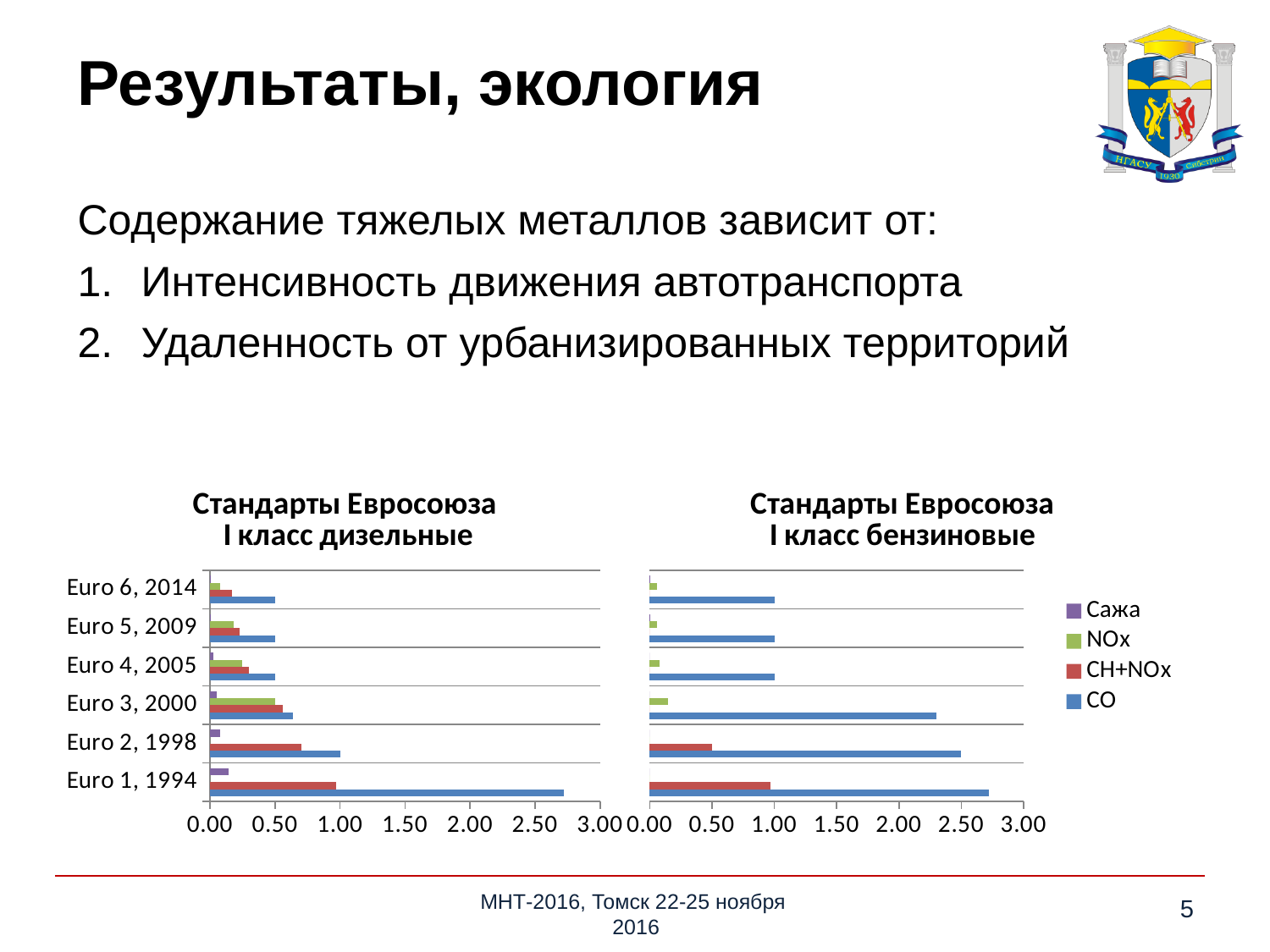
In the left chart 'Стандарты Евросоюза I класс дизельные', is the CO value for Euro 1, 1994 greater or less than 2.50? greater What is the title of the right chart on the slide? Стандарты Евросоюза I класс бензиновые How many series does the legend list for the charts on the slide? 4 In the right chart 'Стандарты Евросоюза I класс бензиновые', which has the larger CO value: Euro 1, 1994 or Euro 3, 2000? Euro 1, 1994 In the left chart 'Стандарты Евросоюза I класс дизельные', is the CH+NOx value for Euro 1, 1994 greater or less than 0.50? greater In the left chart 'Стандарты Евросоюза I класс дизельные', which category has the highest CO value? Euro 1, 1994 In the left chart 'Стандарты Евросоюза I класс дизельные', which has the larger NOx value: Euro 3, 2000 or Euro 6, 2014? Euro 3, 2000 How many categories (Euro standards) are shown on the left chart 'Стандарты Евросоюза I класс дизельные'? 6 In the left chart 'Стандарты Евросоюза I класс дизельные', does the CO value rise or fall going from Euro 1, 1994 to Euro 6, 2014? fall In the right chart 'Стандарты Евросоюза I класс бензиновые', is the CO value for Euro 6, 2014 greater or less than 2.00? less What type of chart is the left chart titled 'Стандарты Евросоюза I класс дизельные'? bar chart